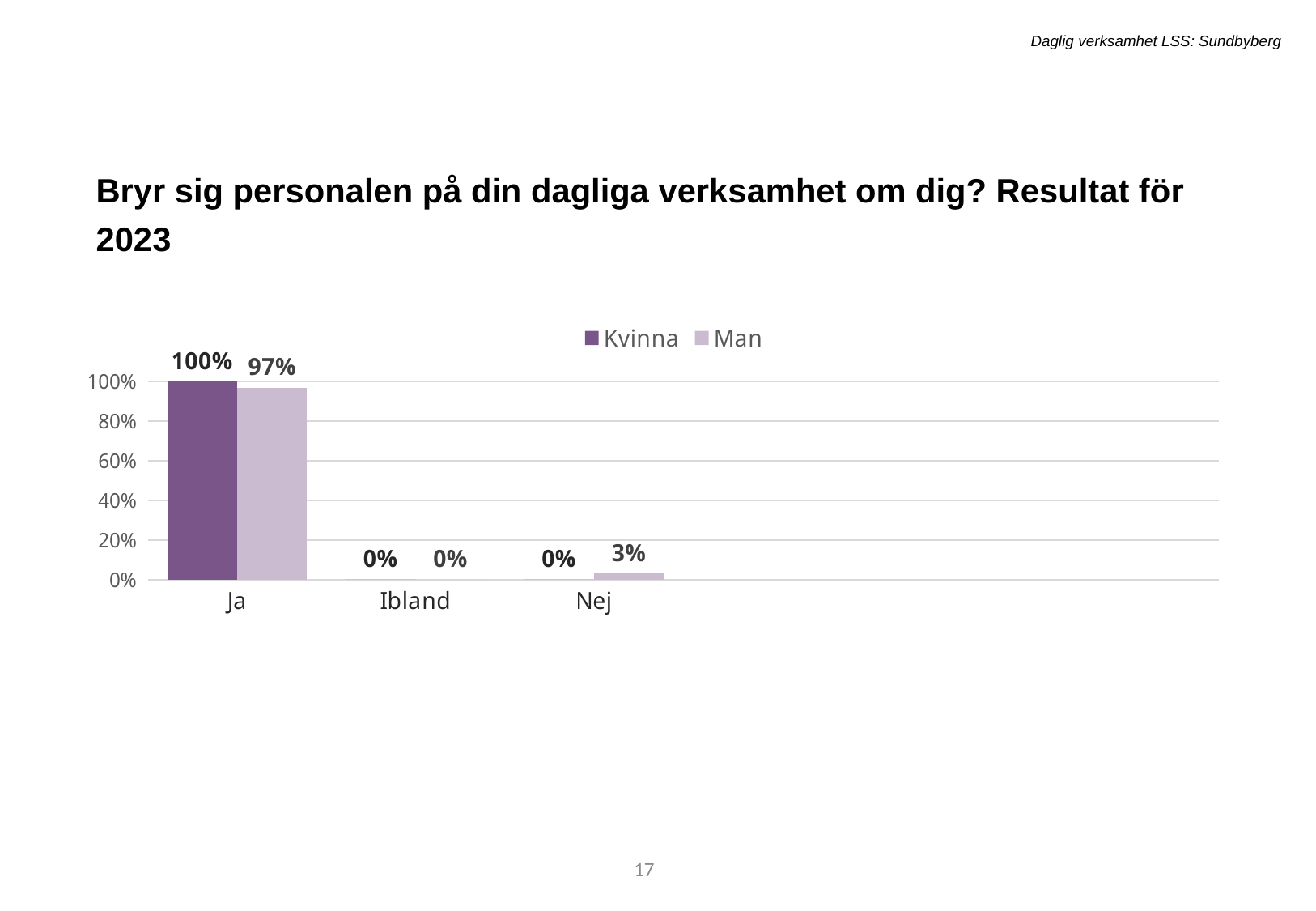
What kind of chart is shown on the slide? Bar chart What is the value for Man in the Ja category? 97% Is the value for Man in the Ja category greater or less than 80%? greater How many series does the legend list? 2 What is the value for Kvinna in the Ibland category? 0% Which category has the highest value for the Man series? Ja What is the difference between the Kvinna and Man values in the Ja category? 3% In the Nej category, which series has the larger value, Kvinna or Man? Man What is the value for Kvinna in the Ja category? 100% How many categories are shown on the x axis? 3 What are the two series named in the legend? Kvinna and Man What is the value for Man in the Nej category? 3%